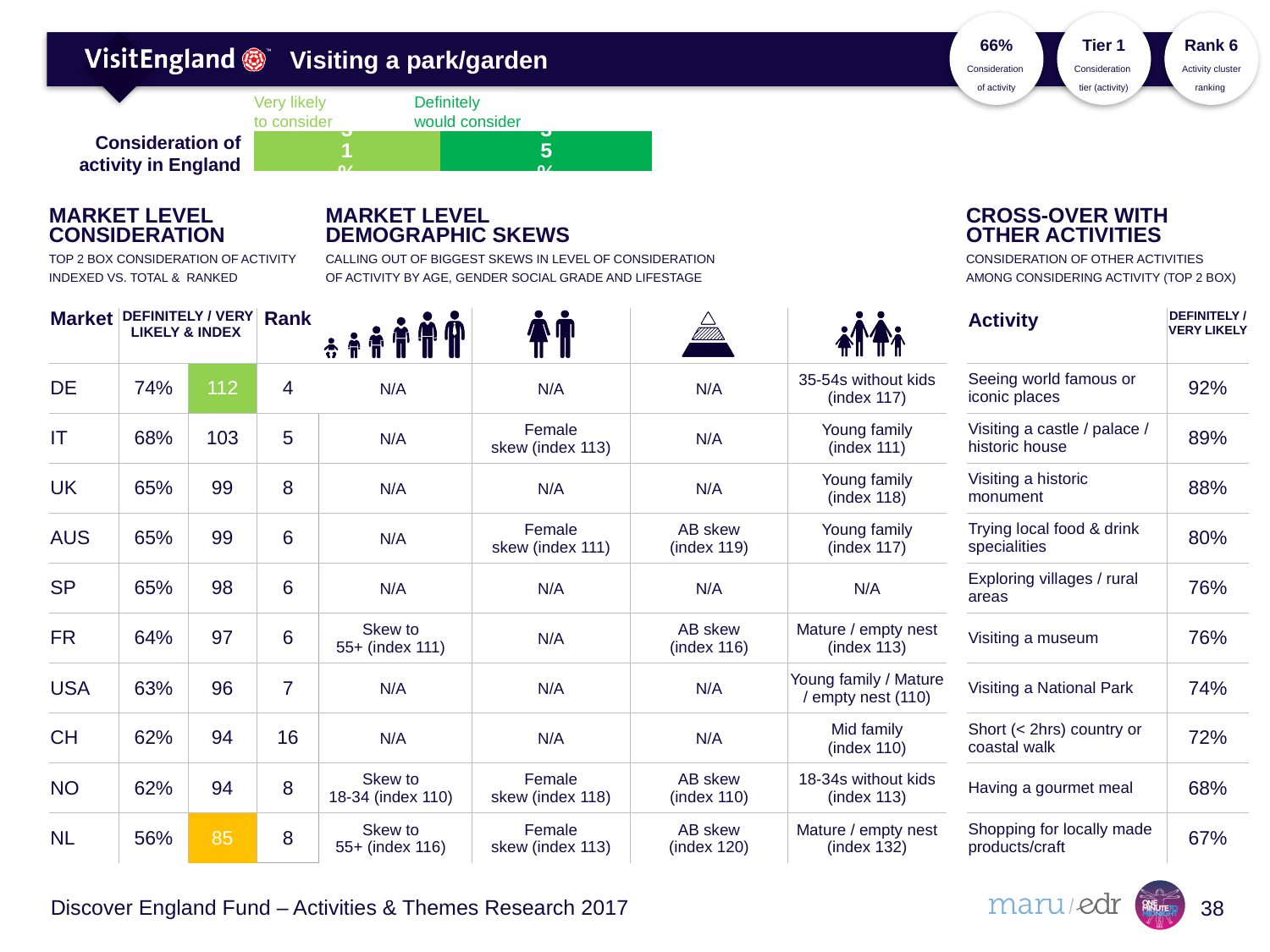
How many bars are plotted in the 'Consideration of activity in England' chart? 1 How many series does the 'Consideration of activity in England' bar chart show? 2 What kind of chart is shown next to 'Consideration of activity in England'? bar chart Which colour is used for the 'Definitely would consider' segment in the 'Consideration of activity in England' bar? dark green In the 'Consideration of activity in England' bar, which segment is larger: 'Very likely to consider' or 'Definitely would consider'? Definitely would consider What are the two series labels shown above the 'Consideration of activity in England' bar? Very likely to consider; Definitely would consider